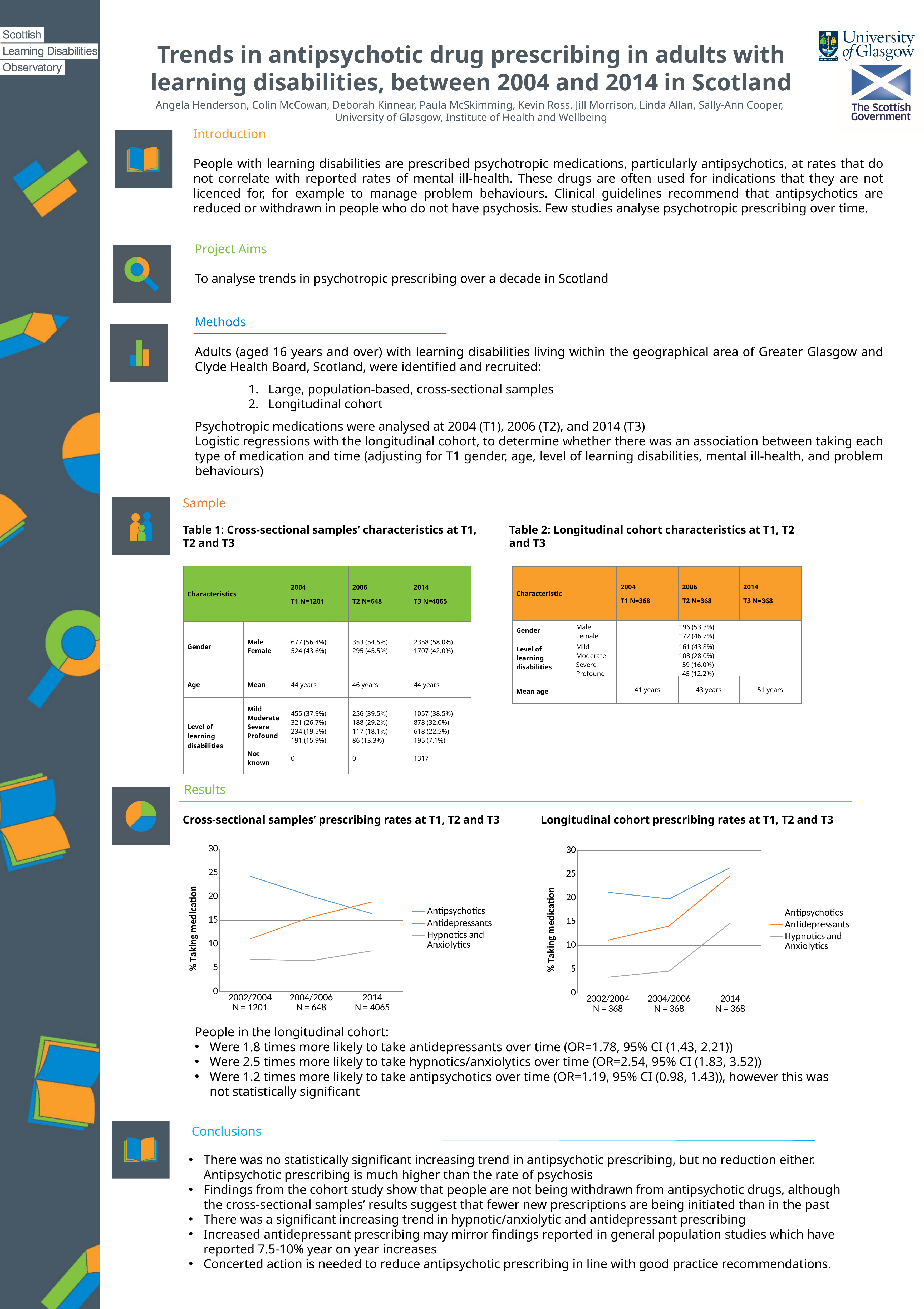
What kind of chart is the 'Cross-sectional samples' prescribing rates at T1, T2 and T3' chart? Line chart In the 'Longitudinal cohort prescribing rates at T1, T2 and T3' chart, which series has the lowest value at 2014? Hypnotics and Anxiolytics In the 'Longitudinal cohort prescribing rates at T1, T2 and T3' chart, does the Antidepressants line rise or fall from 2002/2004 to 2014? Rise How many time points are plotted along the x axis of the 'Cross-sectional samples' prescribing rates at T1, T2 and T3' chart? 3 In the 'Cross-sectional samples' prescribing rates at T1, T2 and T3' chart, does the Antipsychotics line rise or fall from 2002/2004 to 2014? Fall In the 'Longitudinal cohort prescribing rates at T1, T2 and T3' chart, is the Hypnotics and Anxiolytics value at 2002/2004 greater or less than 5? less In the 'Longitudinal cohort prescribing rates at T1, T2 and T3' chart, is the Antipsychotics value at 2014 greater or less than 20? greater In the 'Cross-sectional samples' prescribing rates at T1, T2 and T3' chart, is the Antipsychotics value at 2002/2004 greater or less than 20? greater How many series does the legend of the 'Longitudinal cohort prescribing rates at T1, T2 and T3' chart list? 3 In the 'Longitudinal cohort prescribing rates at T1, T2 and T3' chart, which is larger at 2002/2004: Antipsychotics or Antidepressants? Antipsychotics In the 'Cross-sectional samples' prescribing rates at T1, T2 and T3' chart, which series has the highest value at 2002/2004? Antipsychotics